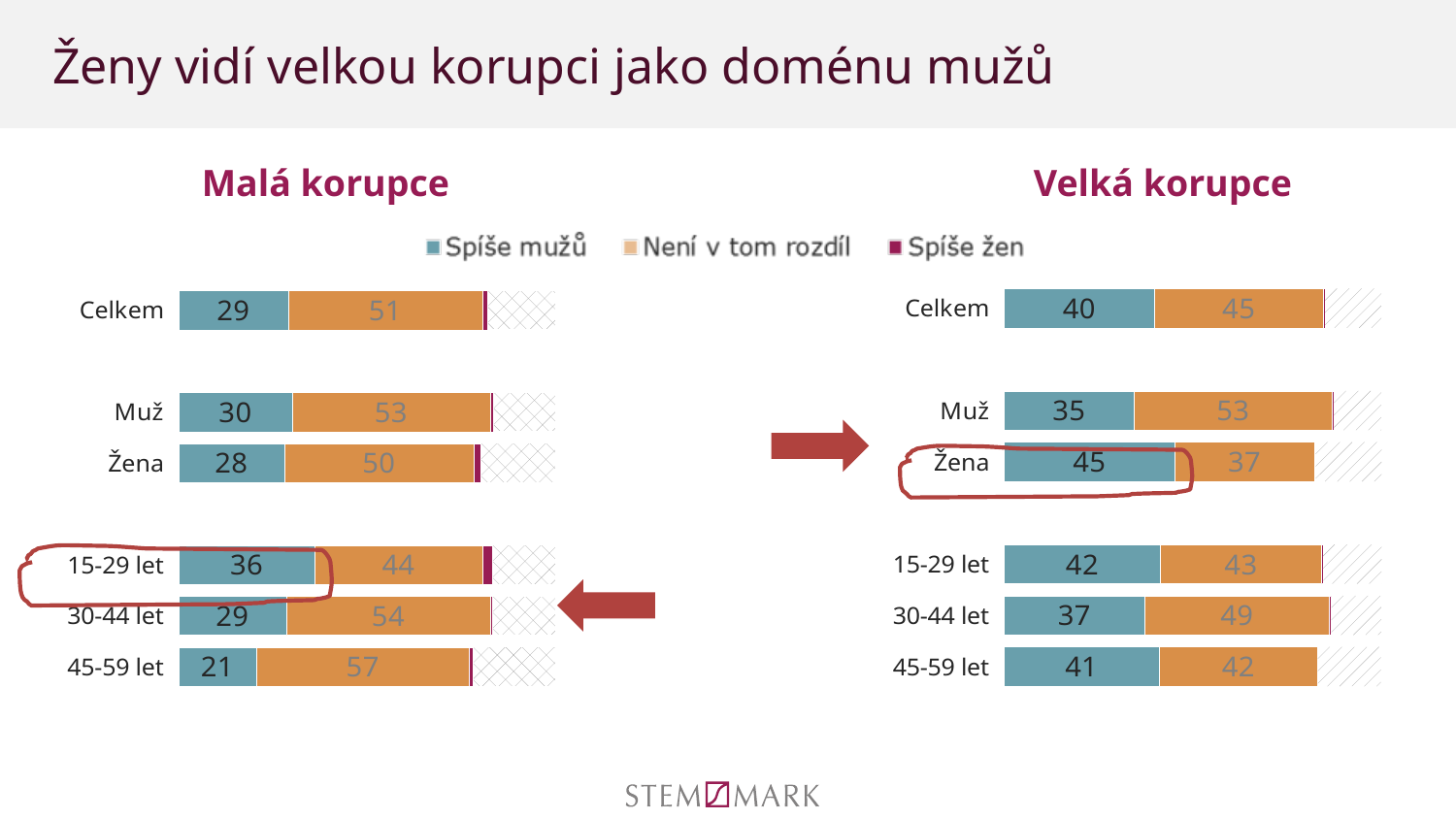
In the Malá korupce chart, which is larger: the Spíše mužů value for Muž or for Žena? Muž In the Velká korupce chart, what is the value of Spíše mužů for Žena? 45 How many categories are shown in the Velká korupce chart? 6 In the Velká korupce chart, which category has the lowest Není v tom rozdíl value? Žena In the Malá korupce chart, which category has the highest Spíše mužů value? 15-29 let How many series does the legend list? 3 In the Malá korupce chart, which category has the lowest Spíše mužů value? 45-59 let In the Malá korupce chart, what is the value of Není v tom rozdíl for 45-59 let? 57 What type of chart is the Malá korupce chart? Stacked bar chart In the Malá korupce chart, what is the value of Spíše mužů for Celkem? 29 In the Velká korupce chart, what is the value of Není v tom rozdíl for Muž? 53 In the Velká korupce chart, what is the difference between the Spíše mužů values for Žena and Muž? 10